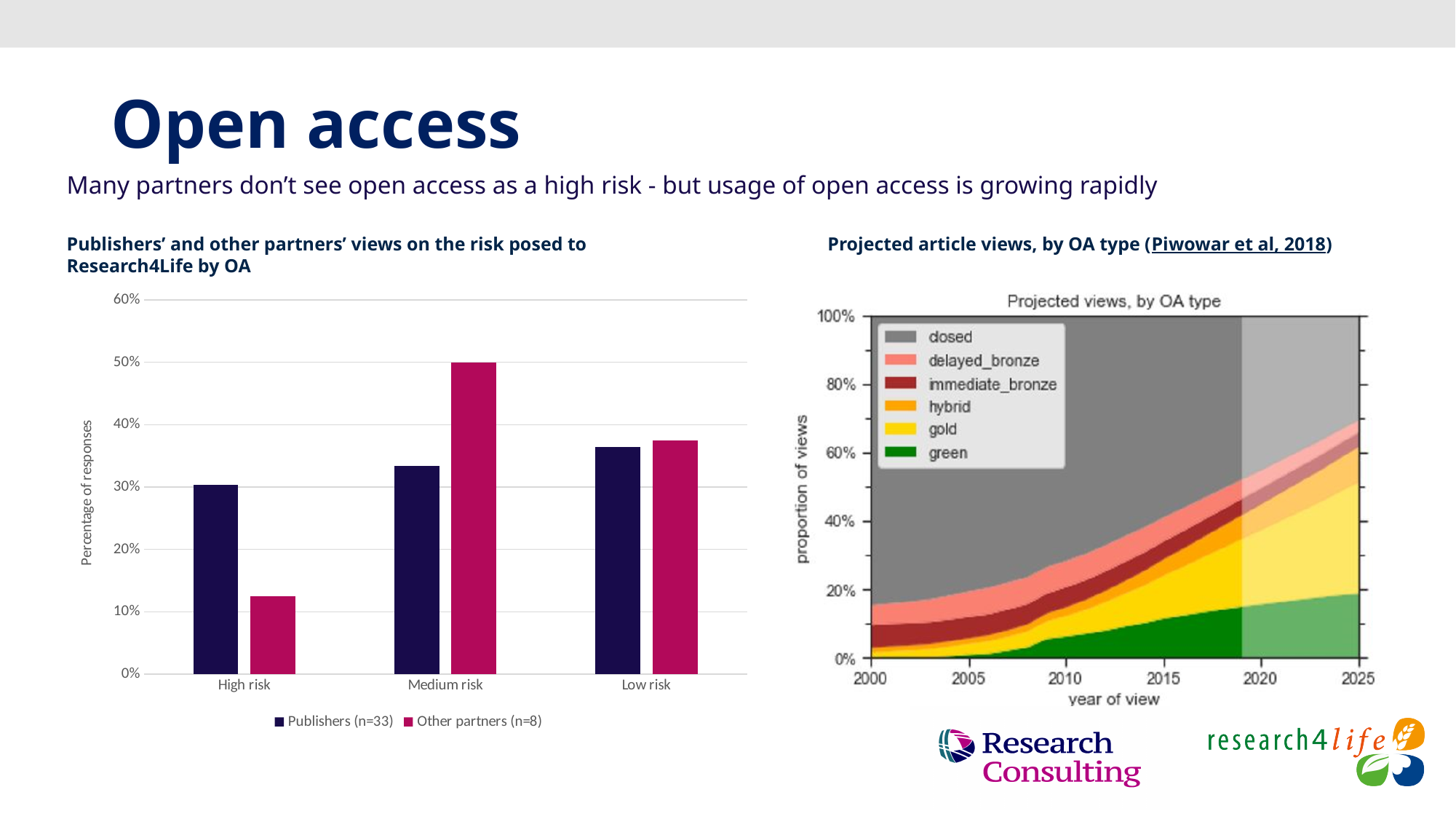
In the left-hand bar chart, is the value for Other partners (n=8) at High risk greater or less than 20%? less In the left-hand bar chart, is the value for Publishers (n=33) at High risk greater or less than 20%? greater In the right-hand chart 'Projected views, by OA type', does the proportion of views for 'closed' rise or fall from 2000 to 2025? Fall In the right-hand chart 'Projected views, by OA type', how many OA types does the legend list? 6 In the left-hand bar chart, which risk category has the lowest value for Other partners (n=8)? High risk In the left-hand bar chart, how many risk categories are shown on the x axis? 3 In the left-hand bar chart, how many series does the legend list? 2 In the left-hand bar chart, for Medium risk, which series has the larger value: Publishers (n=33) or Other partners (n=8)? Other partners (n=8) What kind of chart is the left-hand chart, 'Publishers' and other partners' views on the risk posed to Research4Life by OA'? Bar chart In the left-hand bar chart, which risk category has the highest value for Other partners (n=8)? Medium risk In the left-hand bar chart, for High risk, which series has the larger value: Publishers (n=33) or Other partners (n=8)? Publishers (n=33) In the left-hand bar chart, what percentage of Other partners (n=8) rated OA as Medium risk? 50%